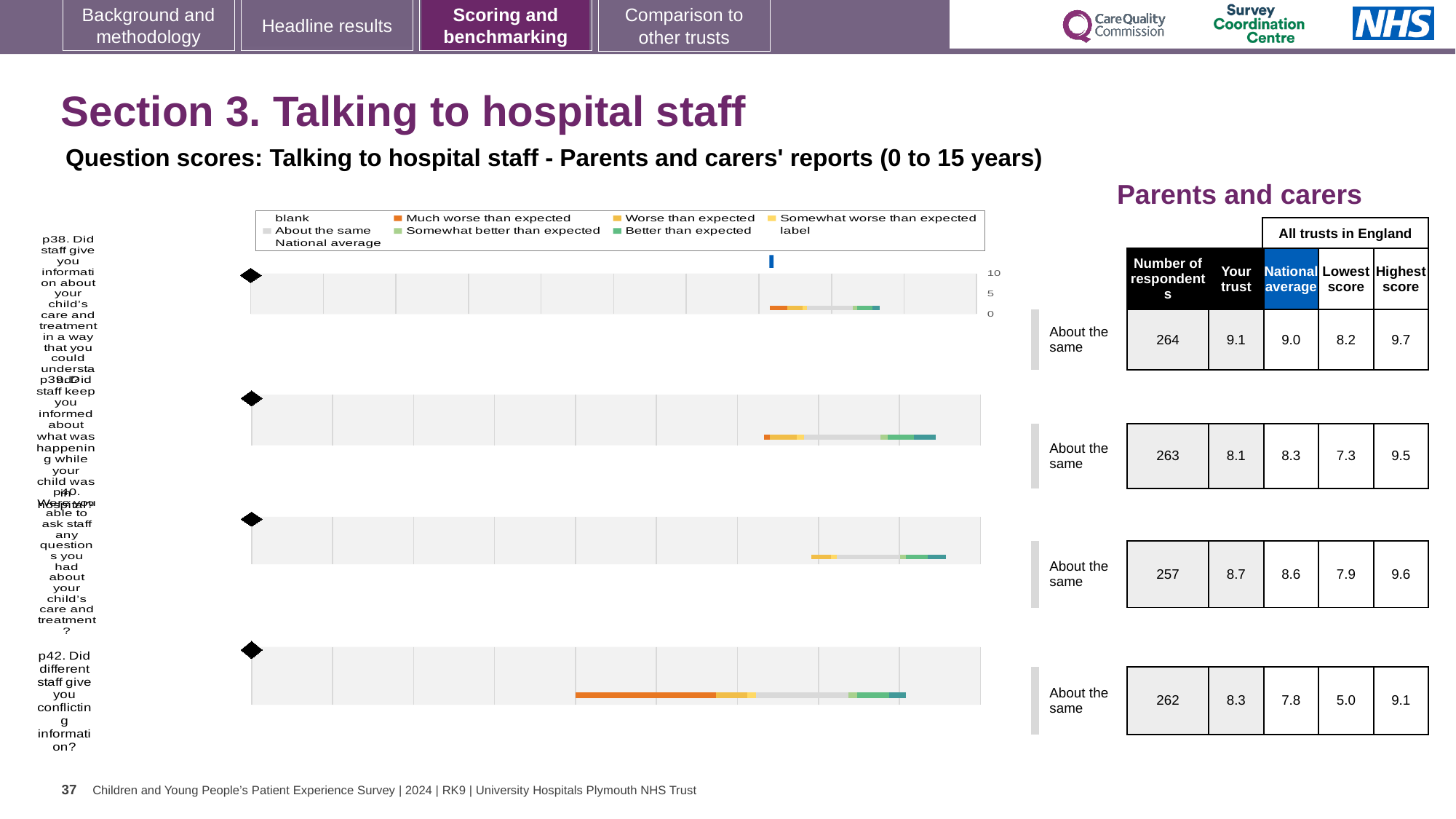
What is the National average score for question p42 (Did different staff give you conflicting information)? 7.8 What is the 'Your trust' score for question p38 (Did staff give you information about your child's care and treatment in a way that you could understand)? 9.1 For question p39, which is larger: the 'Your trust' score or the National average? National average What benchmark label is shown next to each of the four question charts? About the same Which question has the lowest 'Lowest score' across all trusts in England? p42 How many question charts (p38, p39, p40, p42) are shown on the slide? 4 What kind of chart is used to show the question scores on this slide? bar chart Which question has the highest 'Your trust' score? p38 What is the Highest score across all trusts in England for question p39 (Did staff keep you informed about what was happening while your child was in hospital)? 9.5 How many respondents are listed for question p40 (Were you able to ask staff any questions you had about your child's care and treatment)? 257 For question p42, what is the difference between the Highest score and the Lowest score across all trusts in England? 4.1 In the legend, which colour represents 'Much worse than expected'? orange